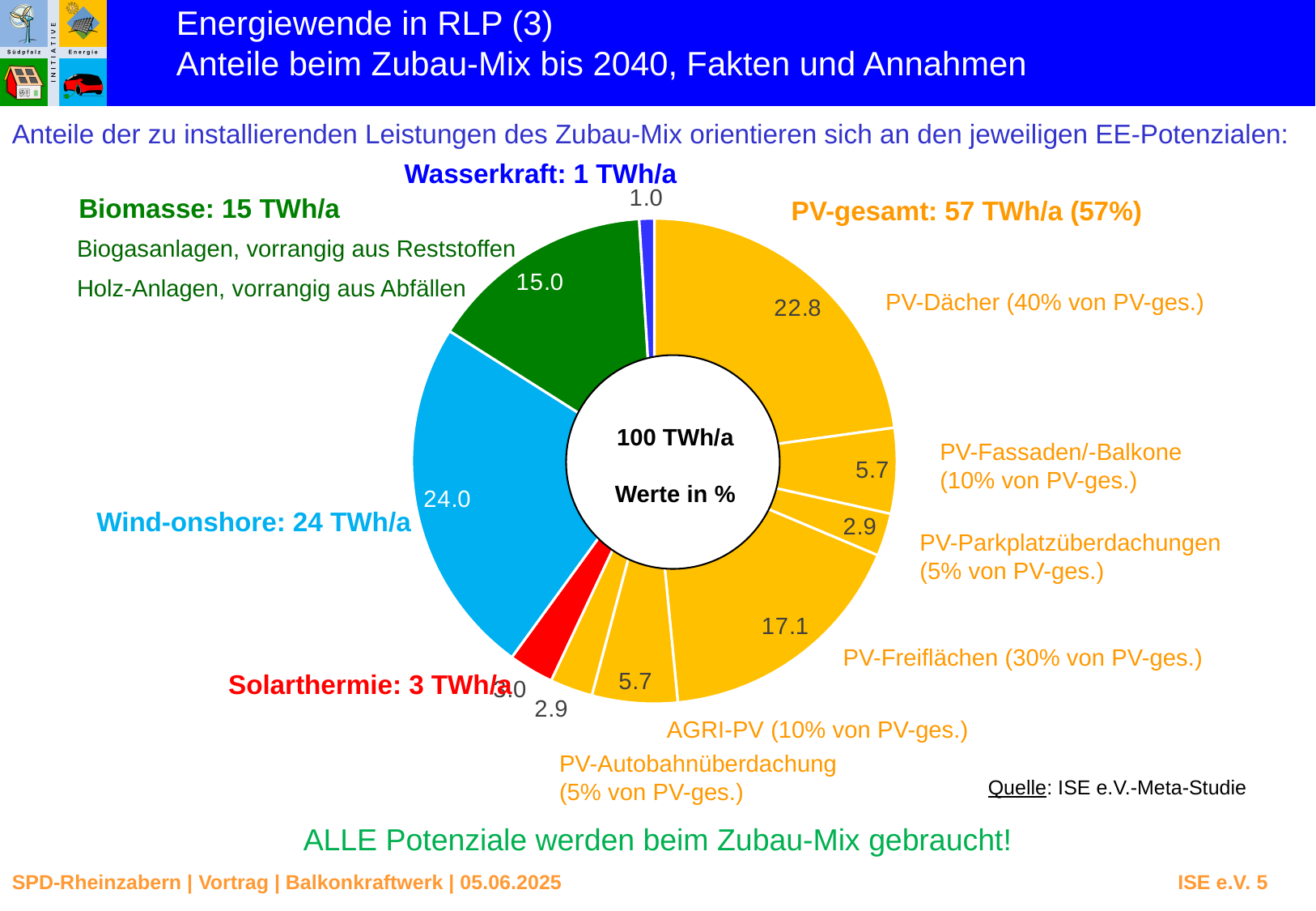
What value is shown for the Biomasse slice? 15.0 Which is larger, the PV-Freiflächen slice or the Biomasse slice? PV-Freiflächen How many slices does the chart have? 10 What value is shown for the PV-Freiflächen slice? 17.1 What is the difference between the Wind-onshore value and the PV-Dächer value? 1.2 What value is shown for the Wasserkraft slice? 1.0 What value is shown for the PV-Dächer slice? 22.8 What value is shown for the Wind-onshore slice? 24.0 What text is written in the centre of the doughnut chart? 100 TWh/a Werte in % What kind of chart is shown on the slide? Doughnut (pie) chart Which slice has the largest value? Wind-onshore Which slice has the smallest value? Wasserkraft